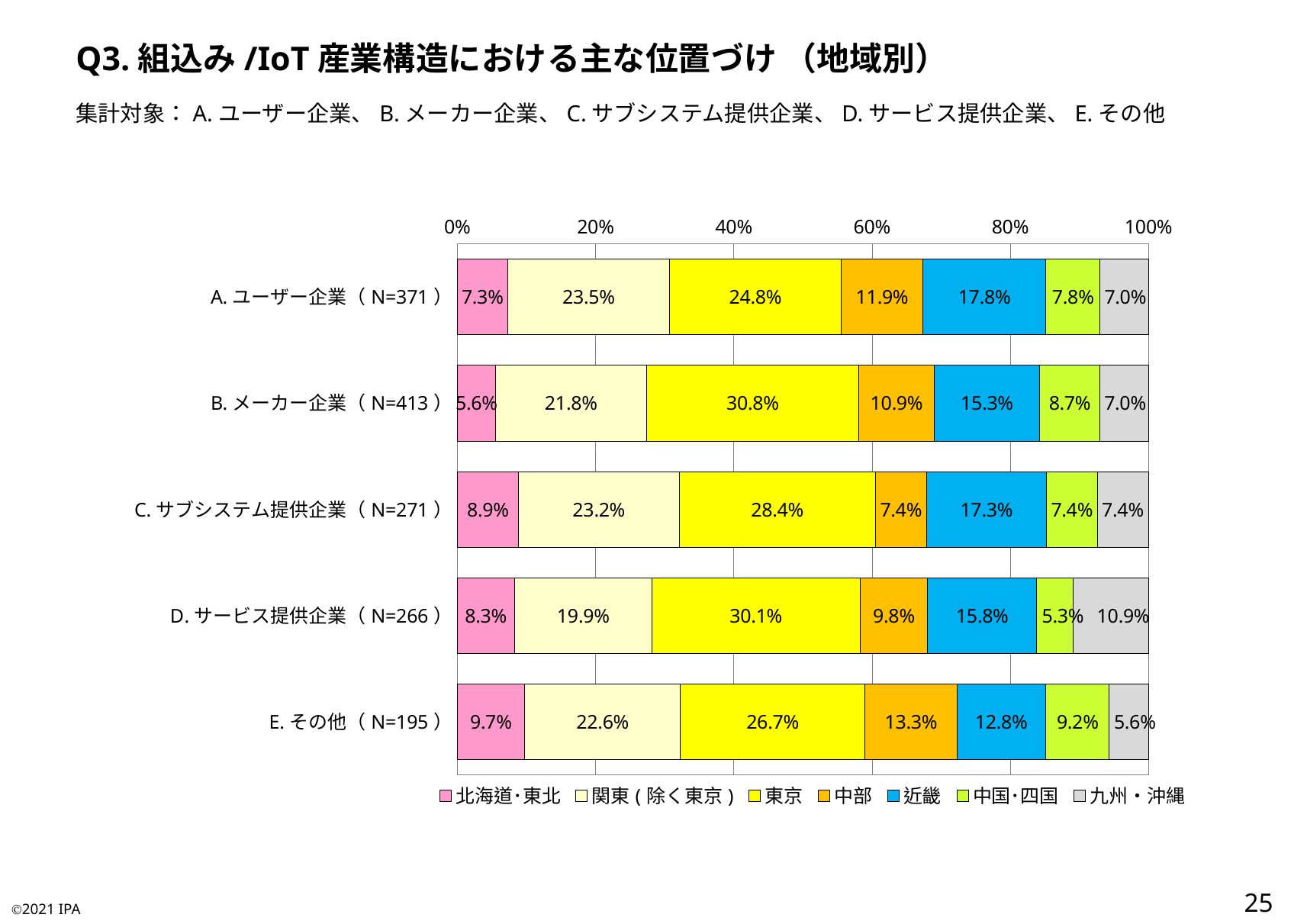
What is the 中部 share for E. その他 (N=195)? 13.3% What is the 近畿 share for A. ユーザー企業 (N=371)? 17.8% Which category has the lowest 北海道・東北 share? B. メーカー企業 (N=413) How many categories (bars) are shown in the chart? 5 What kind of chart is shown on the slide? Stacked bar chart What is the 九州・沖縄 share for D. サービス提供企業 (N=266)? 10.9% How many series does the legend list? 7 What is the 東京 share for B. メーカー企業 (N=413)? 30.8% Which series is shown in blue in the legend? 近畿 Which category has the highest 東京 share? B. メーカー企業 (N=413) Which is larger, the 近畿 share for C. サブシステム提供企業 or for E. その他? C. サブシステム提供企業 What is the difference between the 東京 share for B. メーカー企業 and for A. ユーザー企業? 6.0%